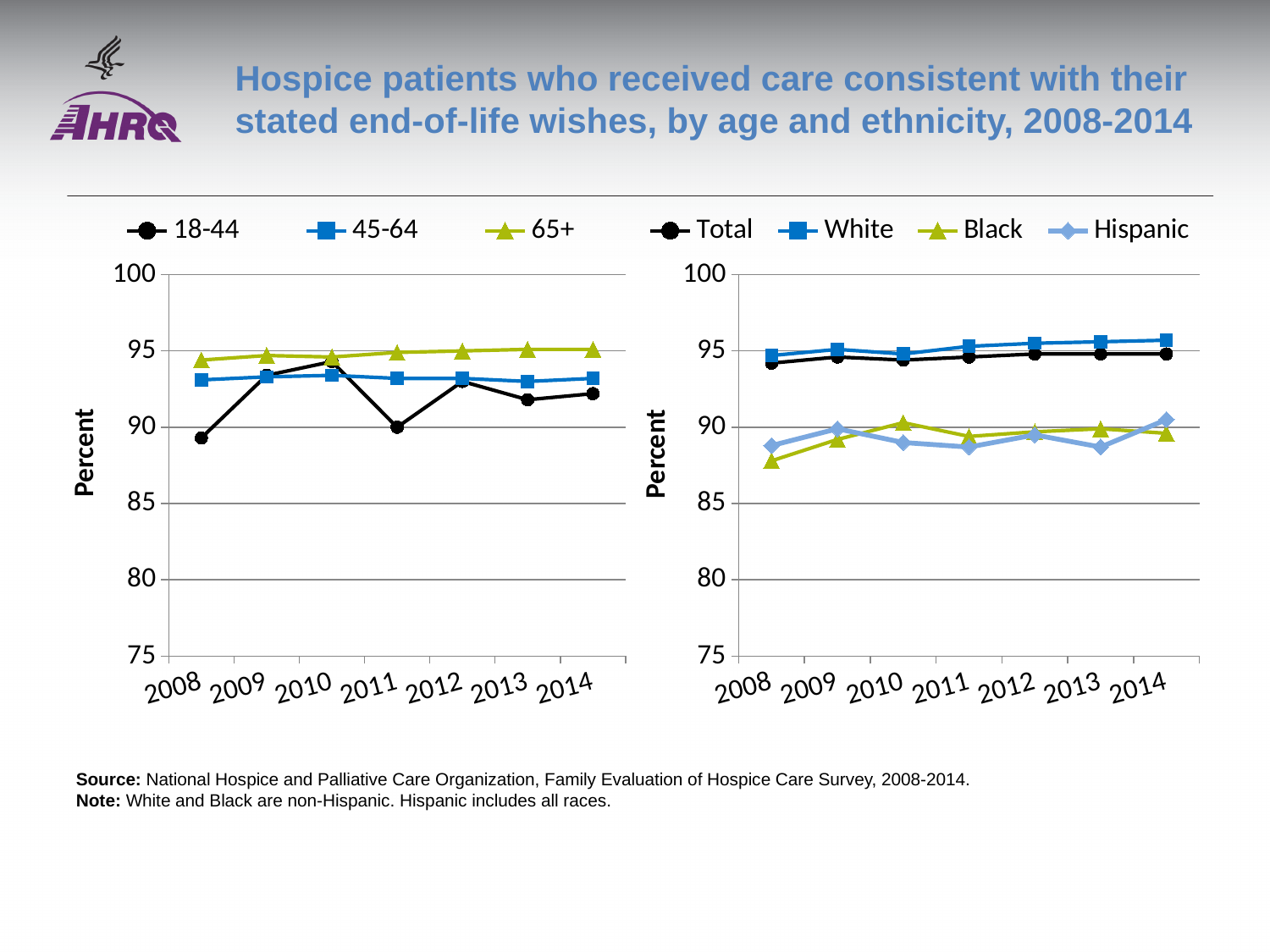
In the right chart (by ethnicity), which group had the lowest value in 2008? Black How many years are shown on the x axis of the right chart (by ethnicity)? 7 What kind of chart is the left chart (by age)? line chart In the right chart (by ethnicity), does the White line rise or fall from 2008 to 2014? rise In the left chart (by age), which age group had the highest value in 2008? 65+ In the right chart (by ethnicity), is the value for Black in 2008 greater or less than 90? less How many series does the legend of the right chart (by ethnicity) list? 4 In the left chart (by age), is the value for 65+ in 2008 greater or less than 95? less How many series does the legend of the left chart (by age) list? 3 In the right chart (by ethnicity), is the value for White in 2014 greater or less than 95? greater In the left chart (by age), which is larger in 2011: the value for 45-64 or the value for 18-44? 45-64